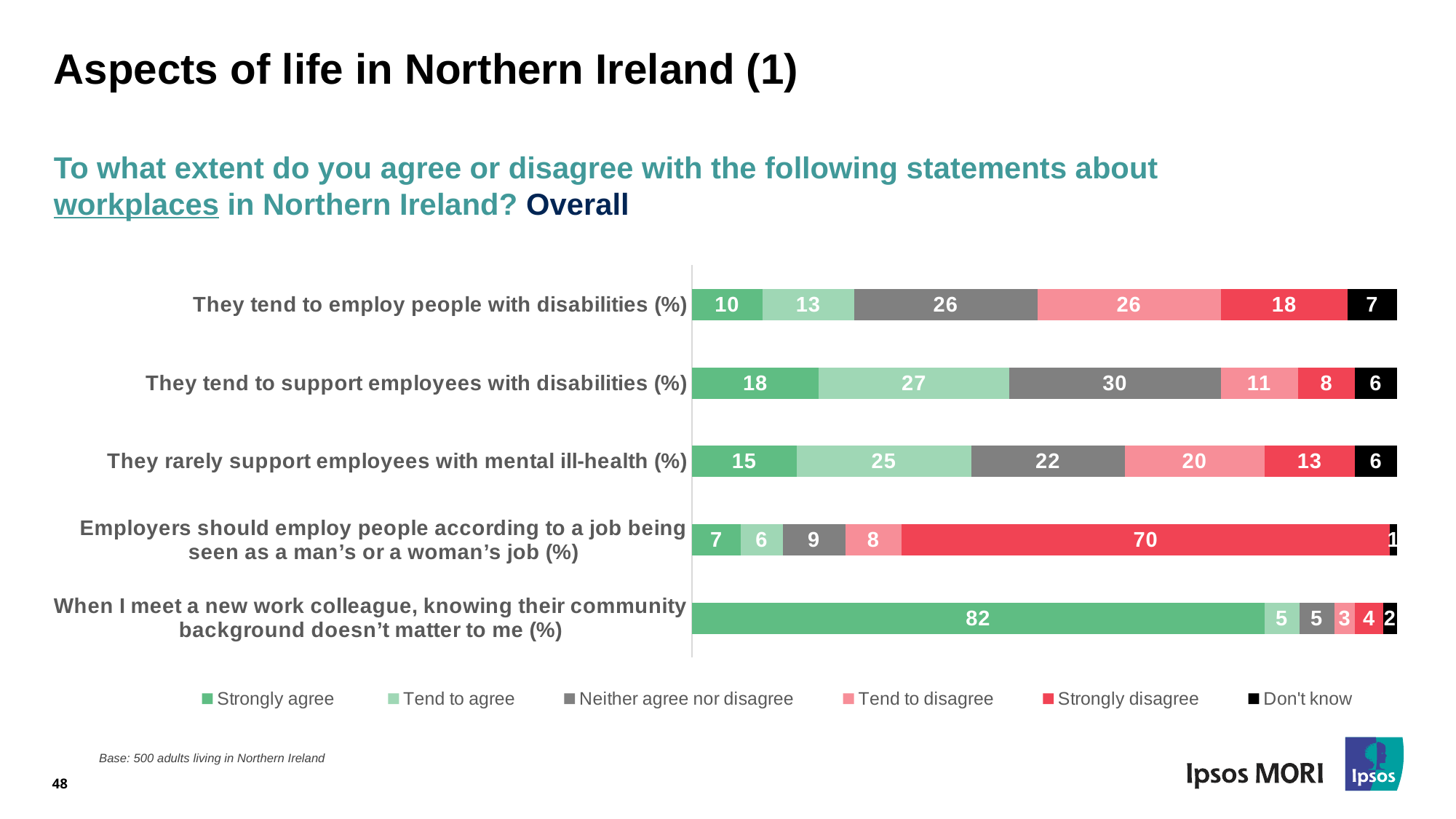
Which statement has the highest 'Strongly agree' value? When I meet a new work colleague, knowing their community background doesn't matter to me How many series does the legend list? 6 How many statements are shown in the chart? 5 What kind of chart is shown on the slide? Stacked bar chart What percentage strongly agree that employers tend to employ people with disabilities? 10 What percentage strongly disagree that employers should employ people according to a job being seen as a man's or a woman's job? 70 What is the 'Don't know' value for 'They rarely support employees with mental ill-health'? 6 What is the total of the stacked bar for 'They tend to employ people with disabilities'? 100 Which is larger: the 'Tend to disagree' value for 'They tend to employ people with disabilities' or for 'They rarely support employees with mental ill-health'? They tend to employ people with disabilities What is the 'Neither agree nor disagree' value for 'They tend to support employees with disabilities'? 30 Which statement has the lowest 'Tend to agree' value? When I meet a new work colleague, knowing their community background doesn't matter to me What is the difference between the 'Tend to agree' values for 'They tend to support employees with disabilities' and 'They tend to employ people with disabilities'? 14